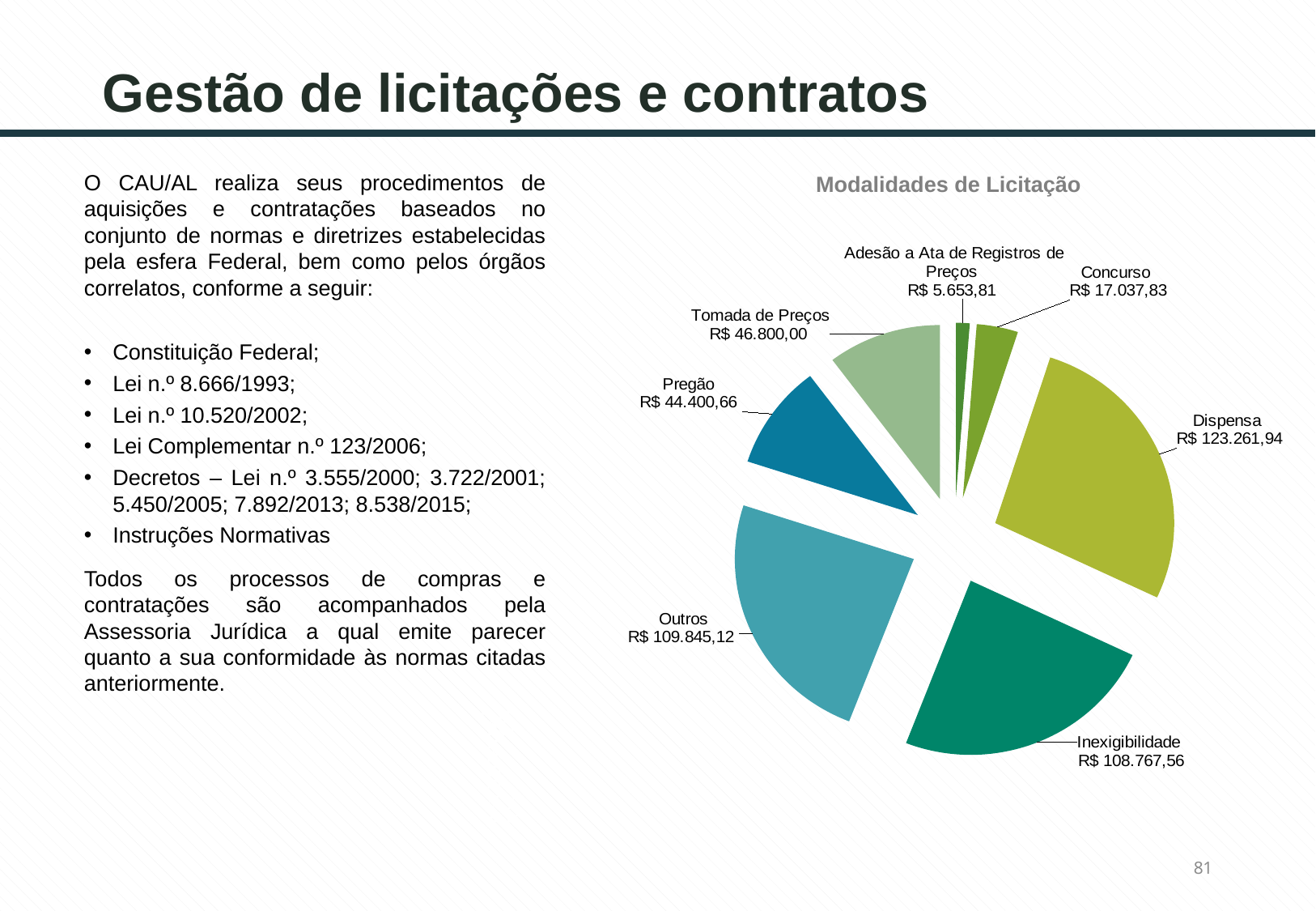
What is the value for Concurso? R$ 17.037,83 Which is larger, Outros or Inexigibilidade? Outros What is the title of the chart? Modalidades de Licitação What type of chart is shown on the slide? Pie chart What is the value for Dispensa? R$ 123.261,94 What is the value for Adesão a Ata de Registros de Preços? R$ 5.653,81 What is the difference between Dispensa and Outros? R$ 13.416,82 How many slices does the pie chart have? 7 What is the value for Pregão? R$ 44.400,66 Which modality has the smallest value? Adesão a Ata de Registros de Preços What is the difference between Tomada de Preços and Pregão? R$ 2.399,34 Which modality has the largest value? Dispensa